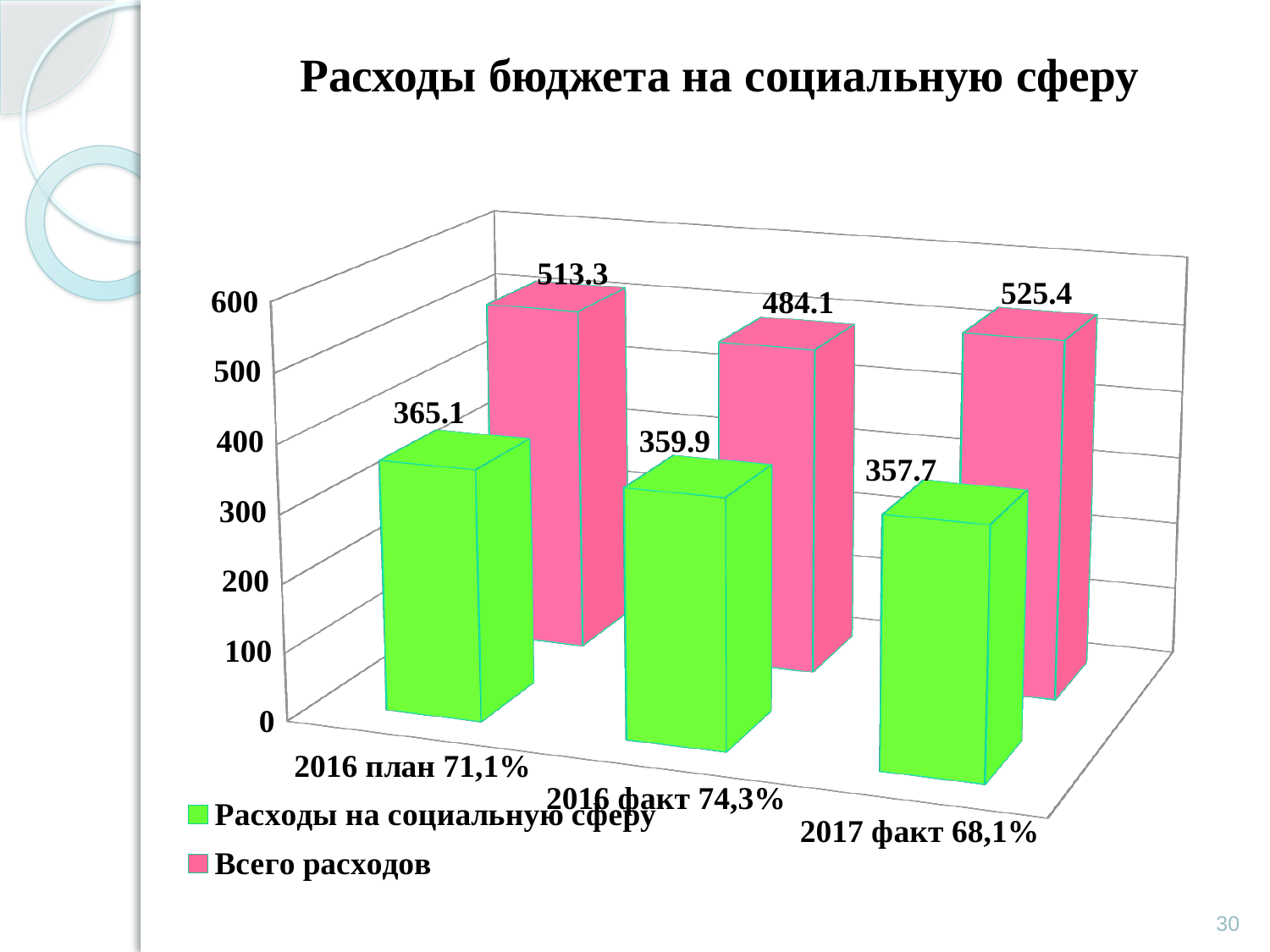
How many series does the legend list? 2 Which is larger: Всего расходов for 2016 план 71,1% or Всего расходов for 2016 факт 74,3%? 2016 план 71,1% How many categories are shown on the x axis? 3 Which category has the lowest value for Расходы на социальную сферу? 2017 факт 68,1% What is the title of the chart? Расходы бюджета на социальную сферу What is the difference between Всего расходов and Расходы на социальную сферу for 2016 план 71,1%? 148.2 What is the value of Расходы на социальную сферу for 2017 факт 68,1%? 357.7 Which category has the highest value for Всего расходов? 2017 факт 68,1% What is the value of Всего расходов for 2016 факт 74,3%? 484.1 What is the value of Всего расходов for 2017 факт 68,1%? 525.4 What kind of chart is shown on the slide? Bar chart What is the value of Расходы на социальную сферу for 2016 план 71,1%? 365.1